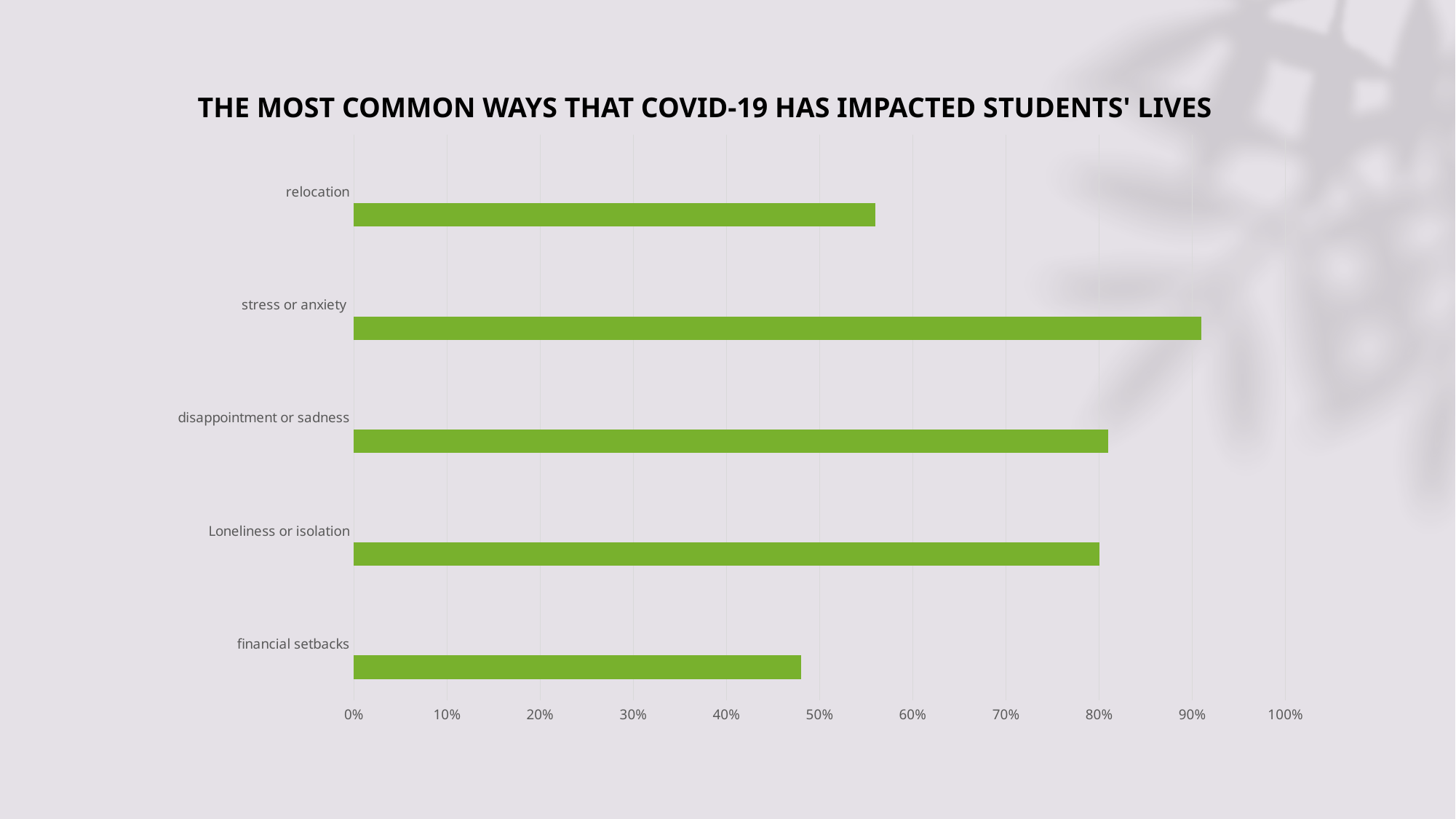
Is the value for stress or anxiety greater or less than 80%? greater What is the title of the chart? THE MOST COMMON WAYS THAT COVID-19 HAS IMPACTED STUDENTS' LIVES Which is larger, the value for stress or anxiety or the value for disappointment or sadness? stress or anxiety How many categories are shown in the chart? 5 Which is larger, the value for relocation or the value for financial setbacks? relocation Which category has the highest value? stress or anxiety Is the value for relocation greater or less than 50%? greater Which category has the lowest value? financial setbacks Is the value for relocation greater or less than 60%? less What kind of chart is shown on the slide? bar chart